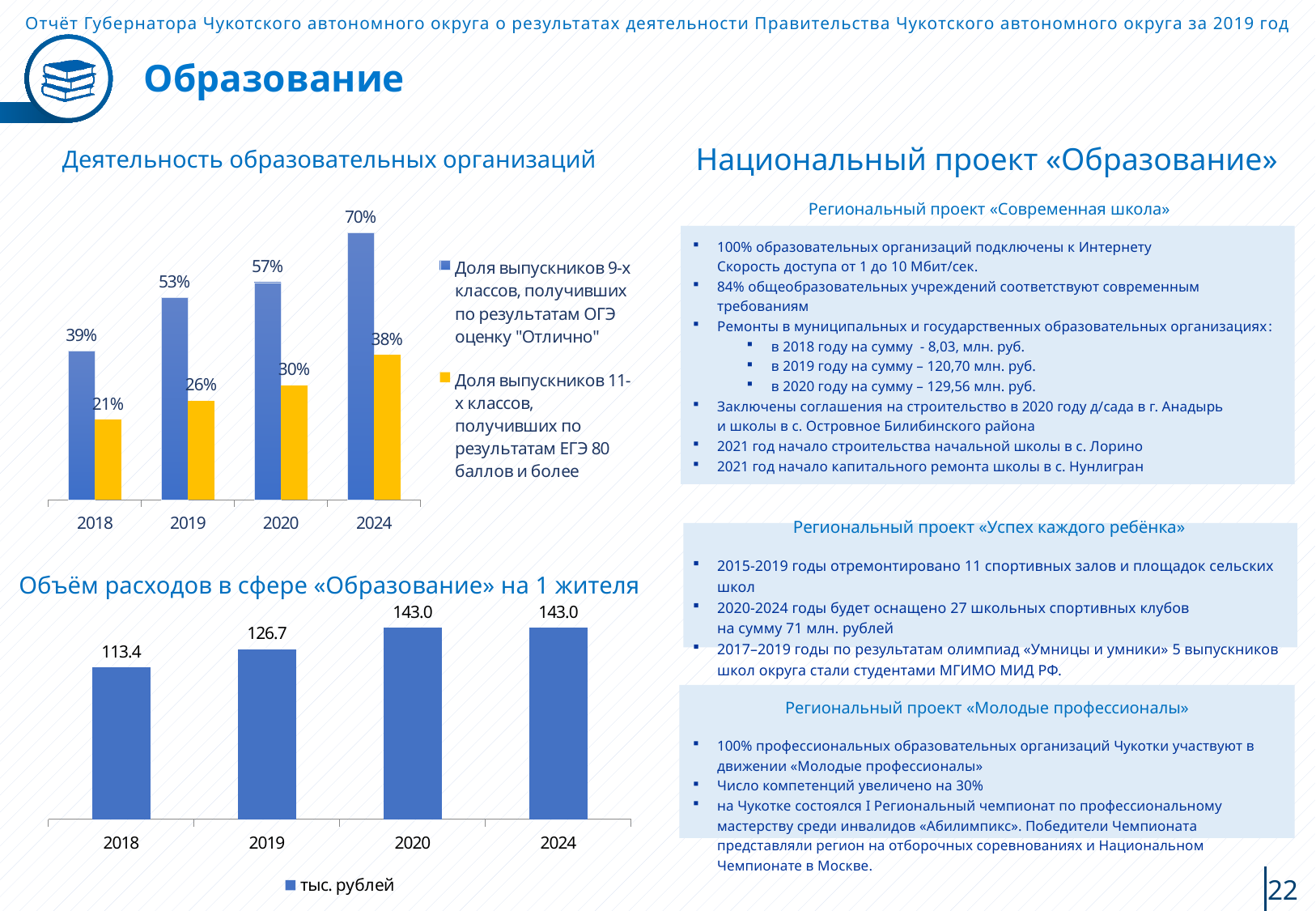
Какого типа диаграмма «Объём расходов в сфере «Образование» на 1 жителя»? Столбчатая (bar chart) На диаграмме «Объём расходов в сфере «Образование» на 1 жителя» на сколько объём расходов в 2020 году больше, чем в 2018 году? 29.6 На диаграмме «Деятельность образовательных организаций» сколько рядов данных указано в легенде? 2 На диаграмме «Деятельность образовательных организаций» на сколько процентных пунктов доля выпускников 9-х классов с оценкой «Отлично» в 2024 году больше, чем в 2018 году? 31 На диаграмме «Объём расходов в сфере «Образование» на 1 жителя» в каком году объём расходов наименьший? 2018 На диаграмме «Объём расходов в сфере «Образование» на 1 жителя» каков объём расходов в 2019 году? 126.7 На диаграмме «Деятельность образовательных организаций» как меняется доля выпускников 11-х классов с 80 баллами и более по ЕГЭ от 2018 к 2024 году? Растёт На диаграмме «Деятельность образовательных организаций» какова доля выпускников 9-х классов, получивших по результатам ОГЭ оценку «Отлично», в 2019 году? 53% На диаграмме «Деятельность образовательных организаций» в каком году доля выпускников 9-х классов с оценкой «Отлично» по ОГЭ наибольшая? 2024 На диаграмме «Деятельность образовательных организаций» в каком году доля выпускников 11-х классов с 80 баллами и более по ЕГЭ наименьшая? 2018 На диаграмме «Деятельность образовательных организаций» какова доля выпускников 11-х классов, получивших по результатам ЕГЭ 80 баллов и более, в 2024 году? 38% На диаграмме «Объём расходов в сфере «Образование» на 1 жителя» сколько категорий (лет) показано? 4